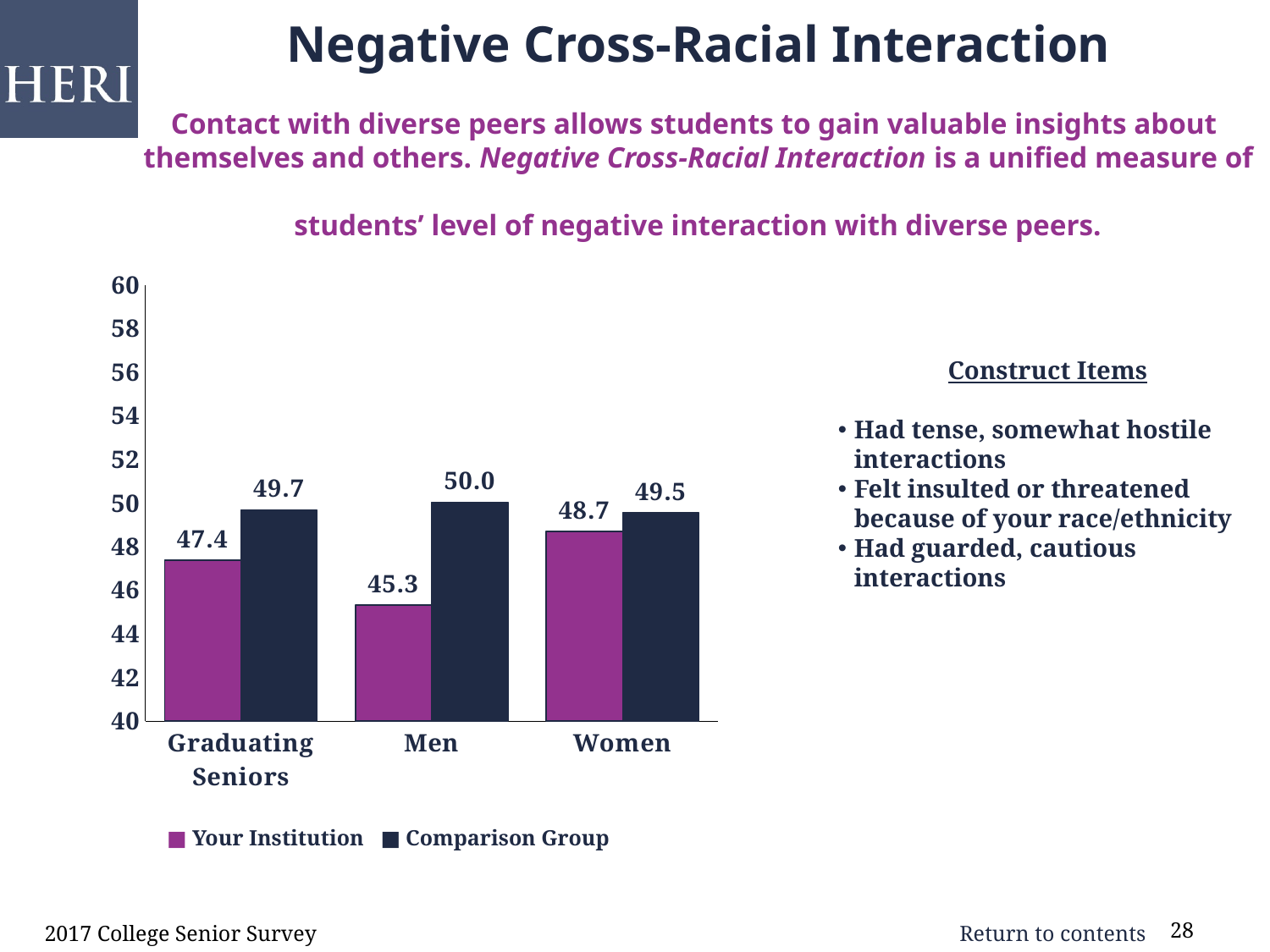
What is the value for Your Institution for Graduating Seniors? 47.4 Which category has the lowest value for Your Institution? Men Is the value for Your Institution for Men greater or less than 46? less What is the value for Your Institution for Women? 48.7 Which category has the highest value for Comparison Group? Men What kind of chart is shown on the slide? bar chart What colour are the Comparison Group bars? dark navy Which is larger for Women: Your Institution or Comparison Group? Comparison Group How many categories are shown on the x axis? 3 What is the difference between the Comparison Group and Your Institution values for Men? 4.7 How many series does the legend list? 2 What is the value for Comparison Group for Men? 50.0